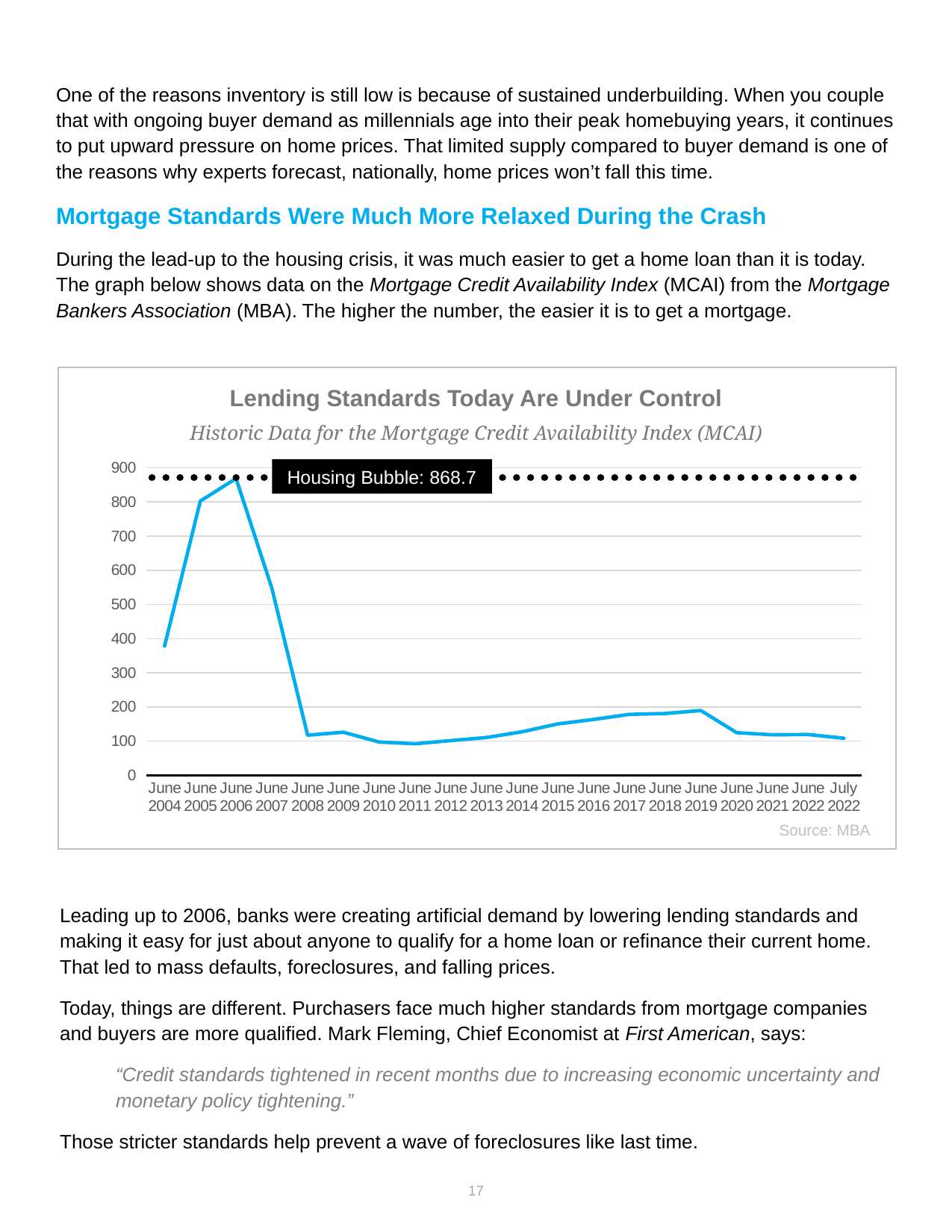
Is the value for July 2022 greater or less than 200? less Is the value for June 2008 greater or less than 200? less How many time points are labelled along the x axis of the chart? 20 What kind of chart is shown on the slide? line chart Which is larger, the value for June 2005 or the value for June 2008? June 2005 Is the value for June 2005 greater or less than 700? greater What value does the dotted 'Housing Bubble' reference line mark on the chart? 868.7 In which period does the MCAI line reach its highest point? June 2006 What is the title of the chart? Lending Standards Today Are Under Control What source is cited for the chart's data? MBA Does the MCAI line rise or fall between June 2006 and June 2008? fall